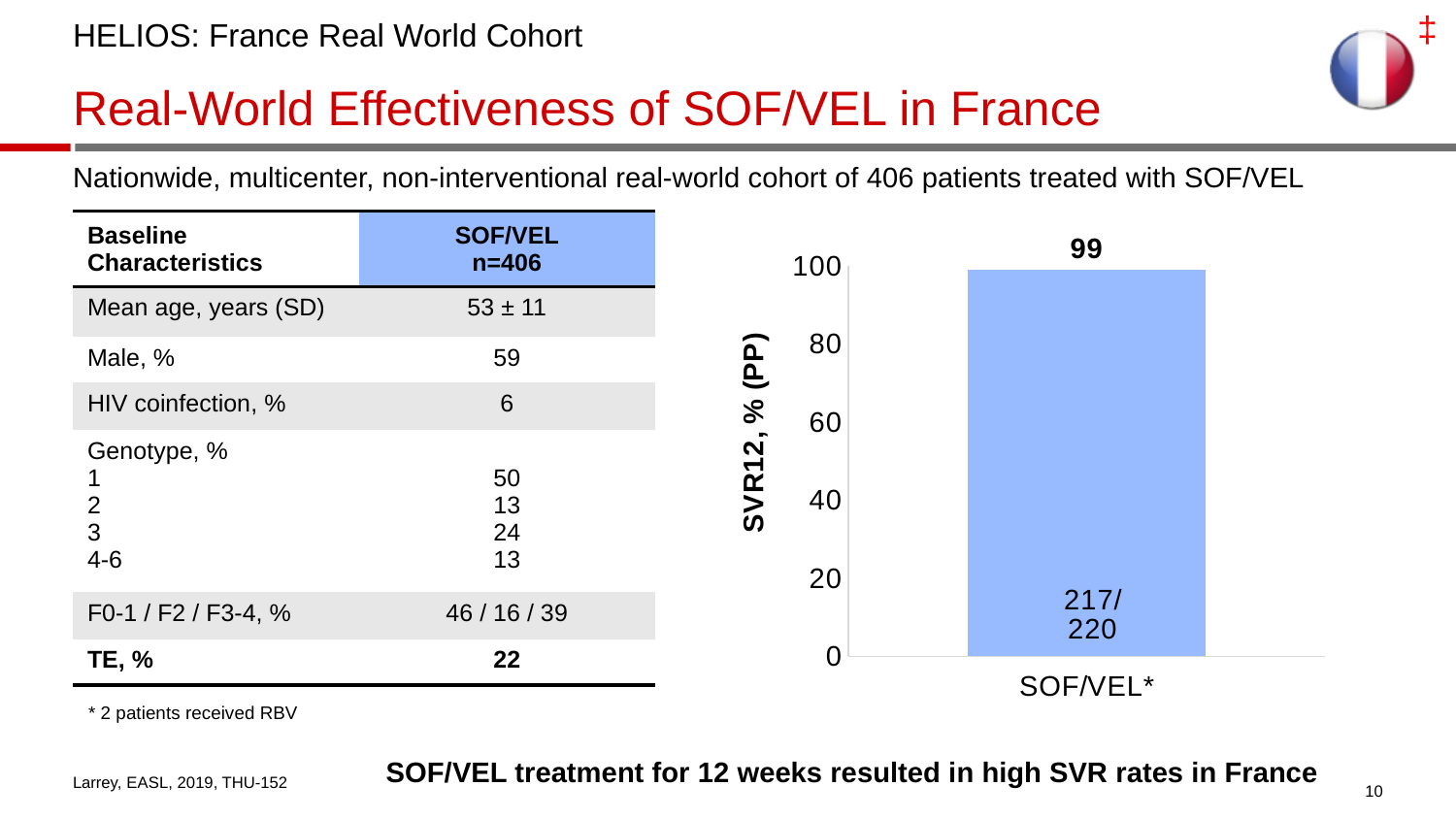
What is the SVR12 value shown for SOF/VEL* in the bar chart? 99 What is the label on the y-axis of the chart? SVR12, % (PP) Is the SVR12 value for SOF/VEL* greater or less than 80? greater What is the category label on the x-axis of the chart? SOF/VEL* How many bars are plotted in the chart? 1 What fraction of patients is printed inside the SOF/VEL* bar? 217/220 What is the maximum value shown on the y-axis of the chart? 100 Is the SVR12 value for SOF/VEL* greater or less than 60? greater What kind of chart is shown on the slide? bar chart